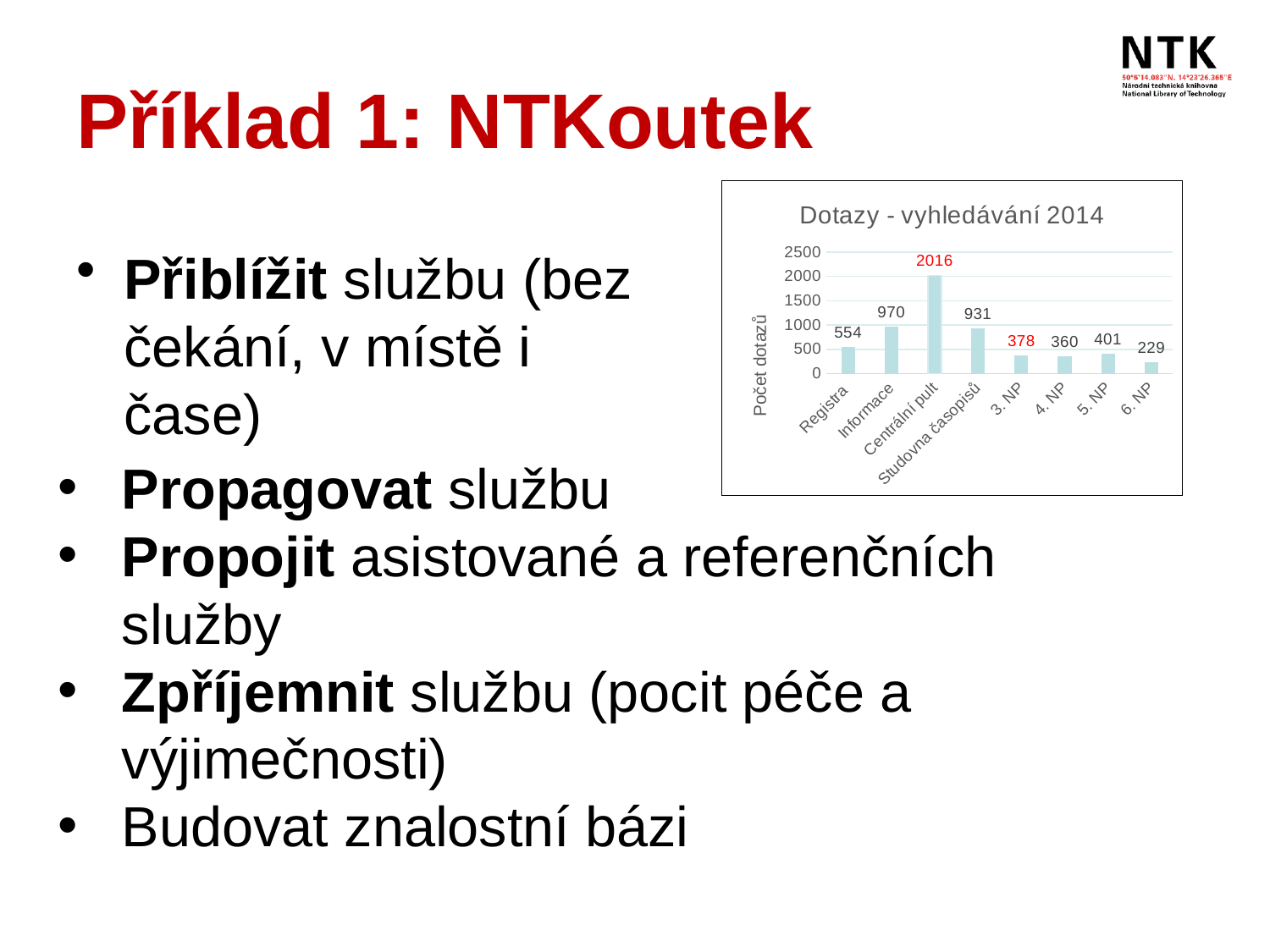
Is the value for Centrální pult greater or less than 1500? greater Which category has the highest value? Centrální pult How many categories are shown on the x axis? 8 What is the value for Registra? 554 What is the label of the vertical axis? Počet dotazů What is the value for Centrální pult? 2016 Which category has the lowest value? 6. NP What is the title of the chart? Dotazy - vyhledávání 2014 What is the value for 3. NP? 378 Which is larger, the value for 5. NP or the value for 4. NP? 5. NP What is the difference between the values for Informace and Studovna časopisů? 39 What kind of chart is shown? bar chart